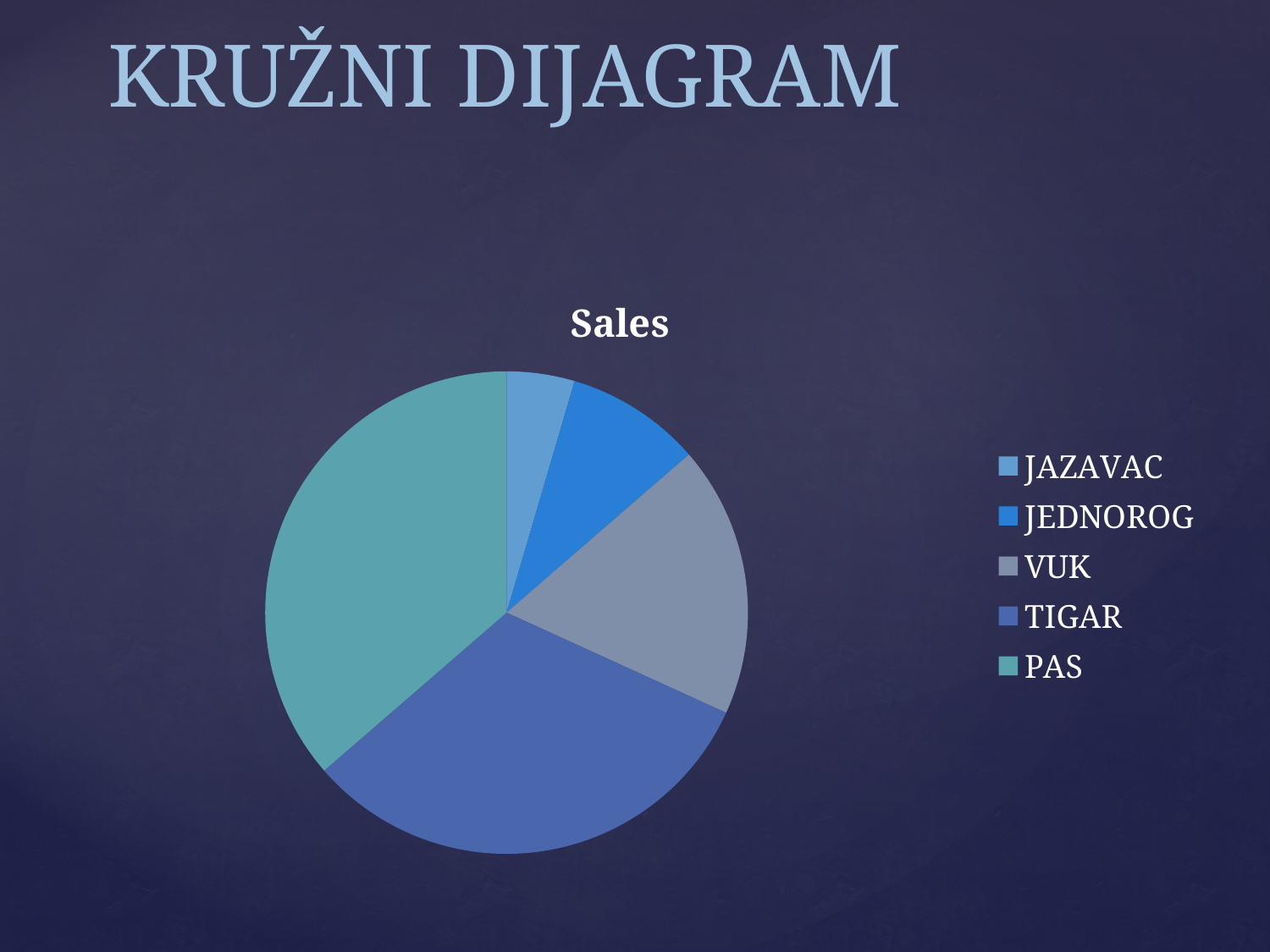
Which slice is larger, VUK or JEDNOROG? VUK Which category is listed first in the legend? JAZAVAC How many entries does the legend list? 5 Which category has the largest slice of the pie? PAS How many categories (slices) does the pie chart have? 5 What is the title of the chart? Sales Which slice is larger, TIGAR or VUK? TIGAR Which category has the smallest slice of the pie? JAZAVAC Which slice is larger, PAS or TIGAR? PAS What kind of chart is shown on the slide? pie chart